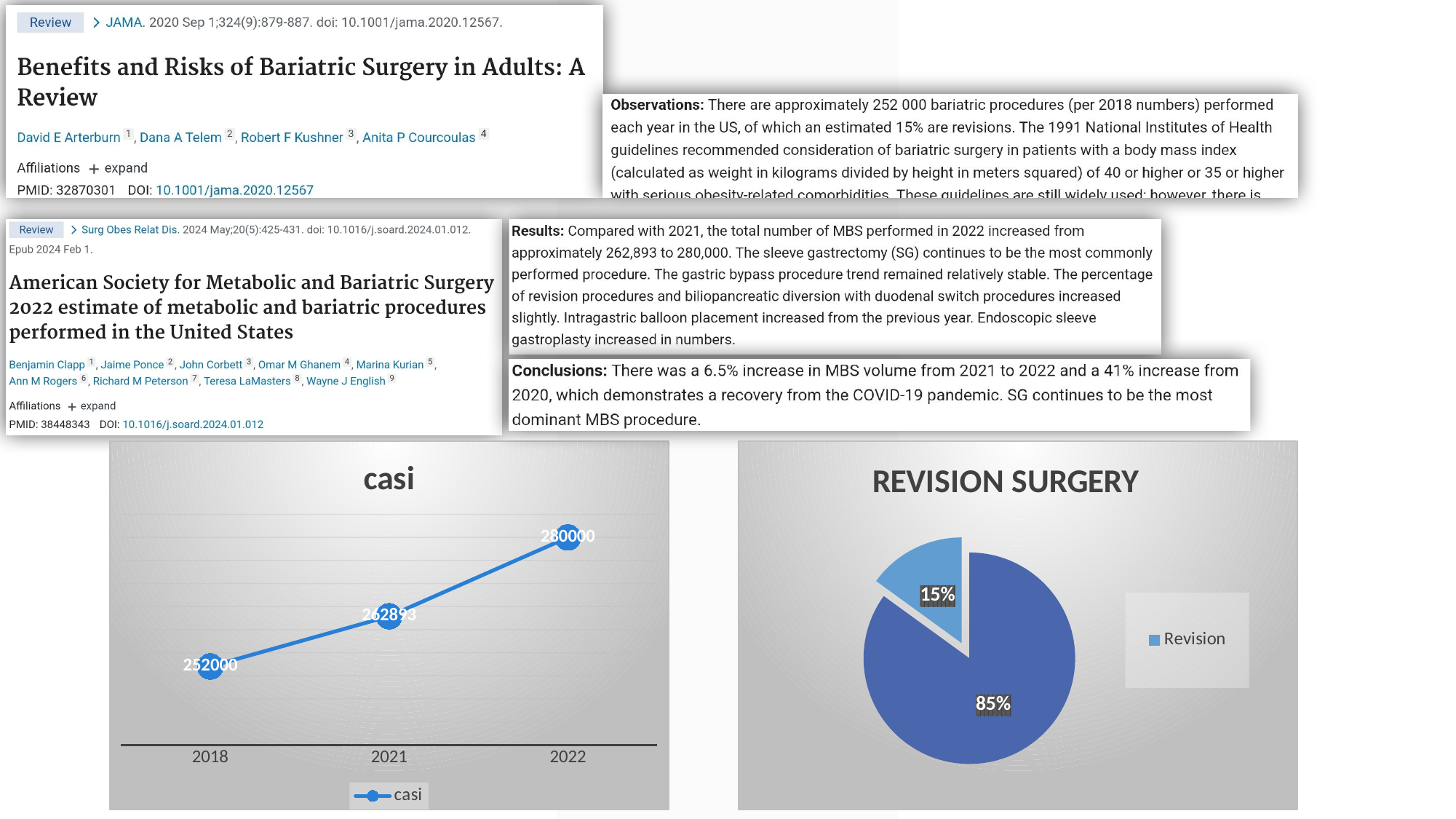
In the 'casi' chart, which year has the highest value? 2022 What kind of chart is the 'casi' chart? line chart How many data points are plotted in the 'casi' chart? 3 In the 'casi' chart, which year has the lowest value? 2018 In the 'REVISION SURGERY' chart, what percentage is shown on the larger slice? 85% In the 'casi' chart, what is the value for 2021? 262893 In the 'REVISION SURGERY' chart, what share of the pie is the Revision slice? 15% What kind of chart is the 'REVISION SURGERY' chart? pie chart In the 'casi' chart, do the values rise or fall from 2018 to 2022? rise In the 'casi' chart, what is the value for 2018? 252000 In the 'casi' chart, what is the difference between the 2022 and 2021 values? 17107 In the 'casi' chart, what is the value for 2022? 280000